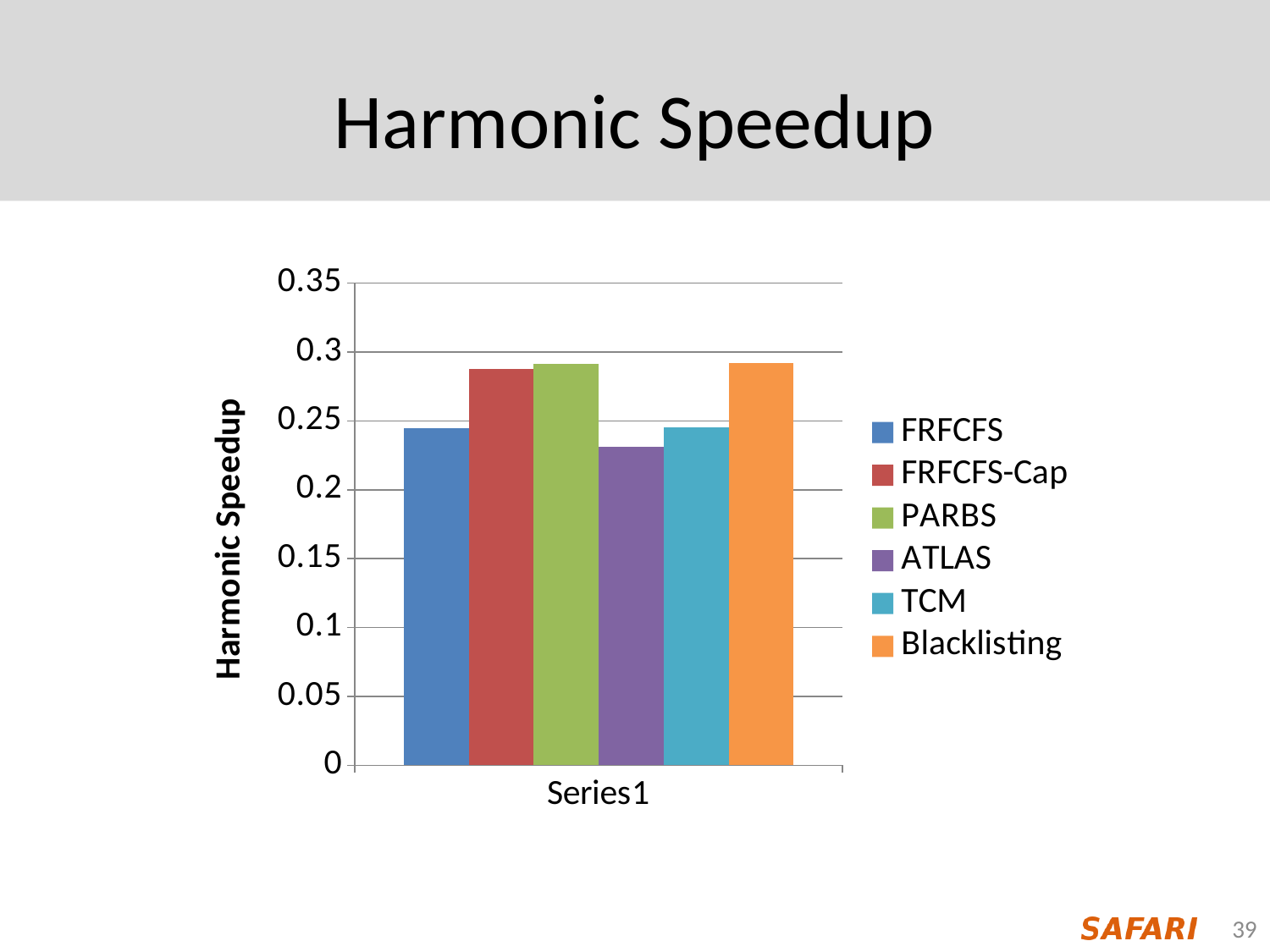
Is the value for PARBS greater or less than 0.25? greater What colour is the bar for Blacklisting? orange Is the value for FRFCFS-Cap greater or less than 0.25? greater Which series has the lowest harmonic speedup? ATLAS What is the label on the vertical axis of the chart? Harmonic Speedup Is the value for ATLAS greater or less than 0.25? less What kind of chart is shown on the slide? bar chart Which is larger, the value for PARBS or the value for FRFCFS? PARBS Which is larger, the value for FRFCFS-Cap or the value for ATLAS? FRFCFS-Cap How many series does the legend list? 6